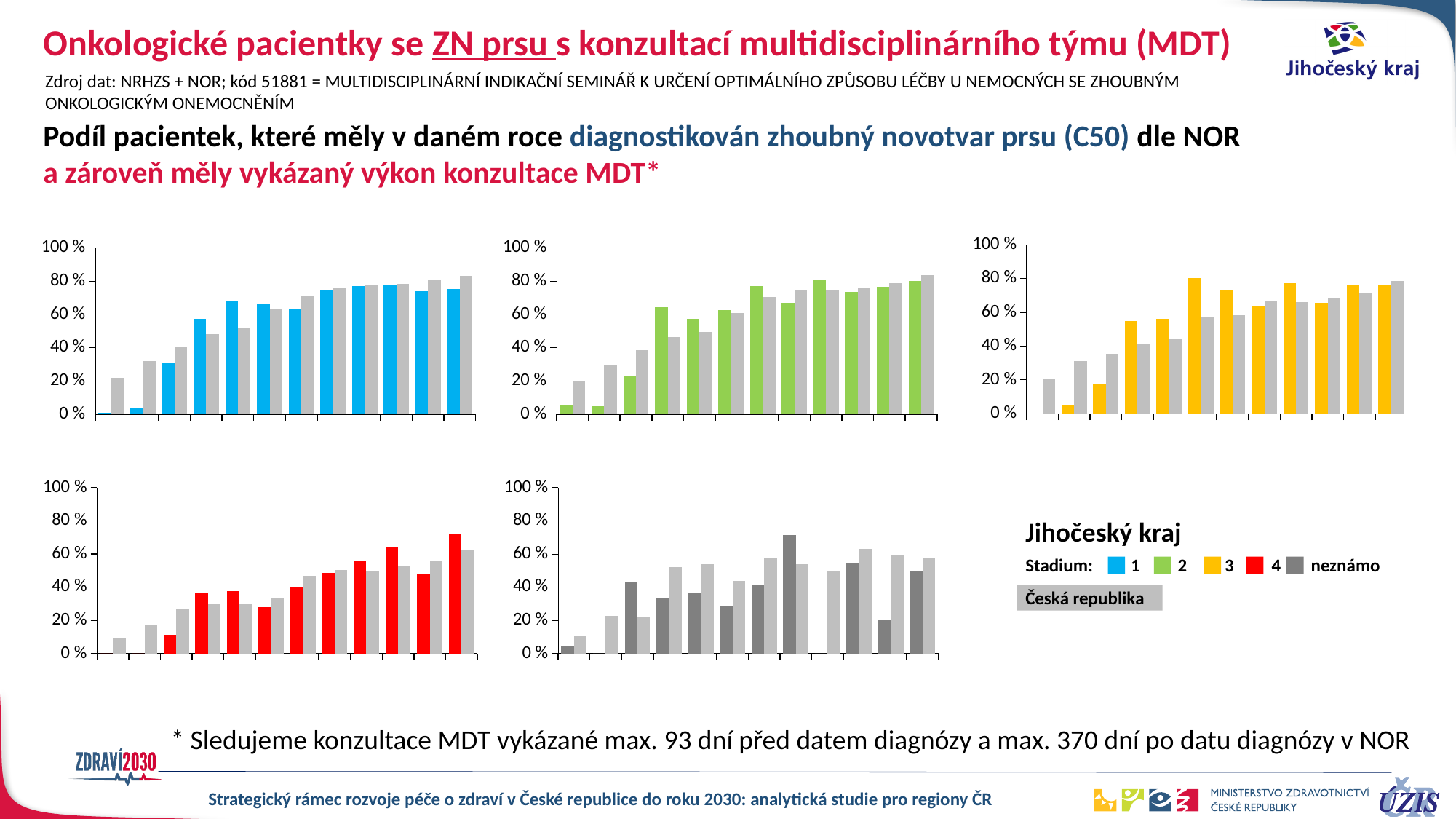
How many charts are on the slide? 5 In the bottom-left chart (red bars, Stadium 4), is the value of the tallest red bar greater or less than 60%? greater In the top-left chart (blue bars, Stadium 1), do the blue bars generally rise or fall from left to right? Rise What kind of charts are shown on the slide? Bar charts In the top-left chart (blue bars, Stadium 1), is the value of the last blue bar greater or less than 60%? greater How many stadium categories does the legend list (excluding Česká republika)? 5 In the top-middle chart (green bars, Stadium 2), is the value of the last green bar greater or less than 60%? greater Which is larger: the last blue bar in the top-left chart or the last red bar in the bottom-left chart? The last blue bar in the top-left chart What do the light grey bars in the charts represent according to the legend? Česká republika Which colour represents Stadium 3 in the legend? Yellow